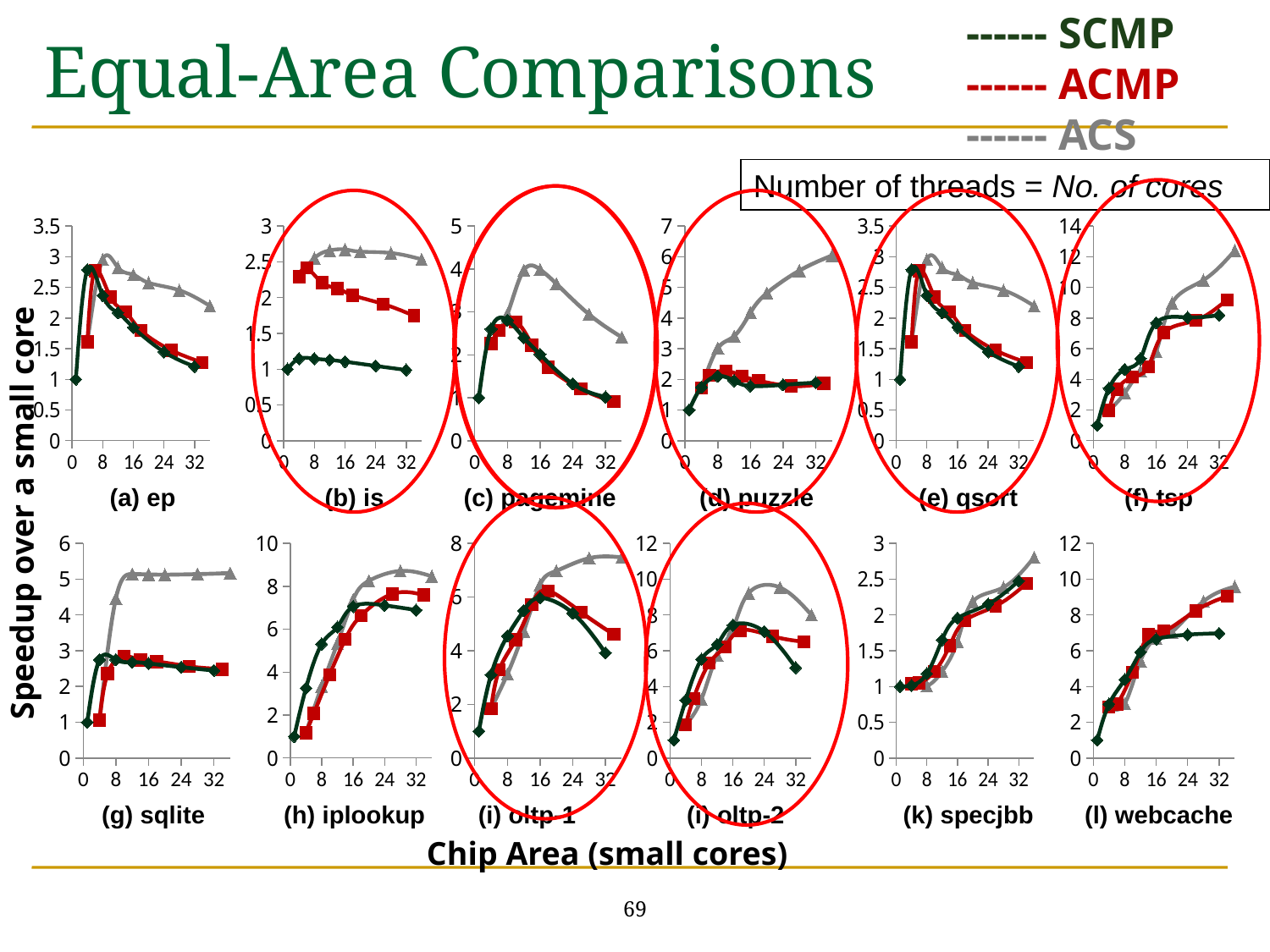
Which series in the legend is drawn in red? ACMP How many series does the legend at the top right list? 3 In the (k) specjbb chart, do the values rise or fall as chip area increases? rise How many benchmark panels (charts) are shown on the slide? 12 In the (b) is chart, is the SCMP value at chip area 32 greater or less than 1.5? less What is the label of the shared x axis at the bottom of the slide? Chip Area (small cores) In the (d) puzzle chart, is the ACS value at chip area 32 greater or less than 5? greater In the (g) sqlite chart, which series has the larger value at chip area 32, ACS or SCMP? ACS What kind of chart is used in each of the panels on the slide? line chart In the (f) tsp chart, is the ACS value at chip area 32 greater or less than 10? greater In the (b) is chart, which series has the larger value at chip area 32, ACMP or SCMP? ACMP